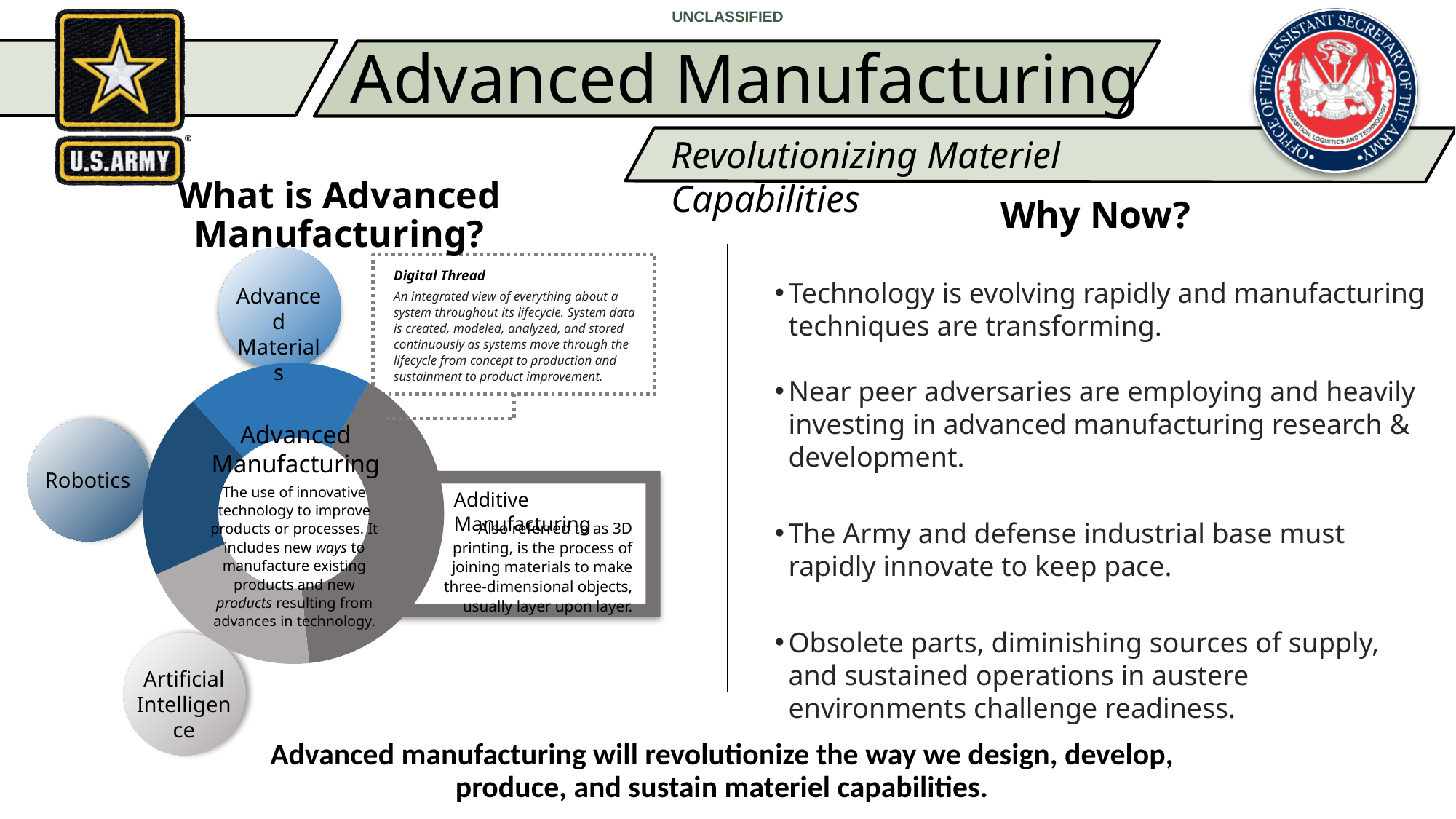
Is the Additive Manufacturing segment of the donut chart larger or smaller than the Artificial Intelligence segment? Larger Which segment of the donut chart is shown in dark gray? Additive Manufacturing What label appears in the center of the donut chart? Advanced Manufacturing How many segments does the donut chart have? 4 Is the Additive Manufacturing segment of the donut chart larger or smaller than the Robotics segment? Larger Which segment of the donut chart is the largest? Additive Manufacturing What kind of chart is shown on the left side of the slide under 'What is Advanced Manufacturing?' Donut chart